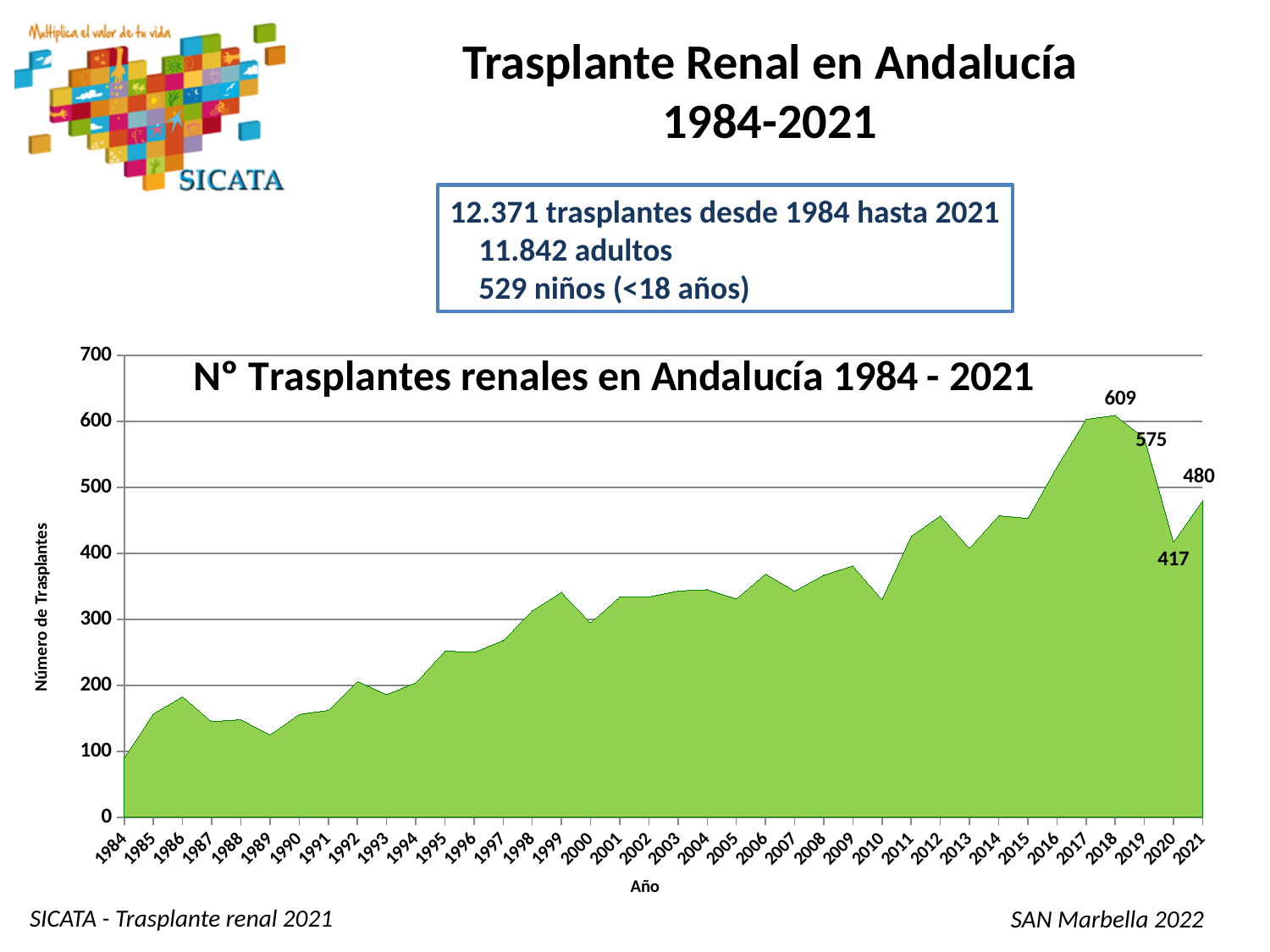
What is the number of kidney transplants in Andalucía in 2020? 417 Which year had more kidney transplants, 2019 or 2021? 2019 Is the number of transplants in 2012 greater or less than 400? greater How many years are plotted on the x axis of the chart? 38 What is the title of the chart? Nº Trasplantes renales en Andalucía 1984 - 2021 What is the difference between the number of transplants in 2018 and in 2020? 192 Which year has the highest number of kidney transplants in the chart? 2018 Is the number of transplants in 1984 greater or less than 100? less What is the number of kidney transplants in Andalucía in 2021? 480 What is the number of kidney transplants in Andalucía in 2018? 609 Which year has the lowest number of kidney transplants in the chart? 1984 What is the number of kidney transplants in Andalucía in 2019? 575